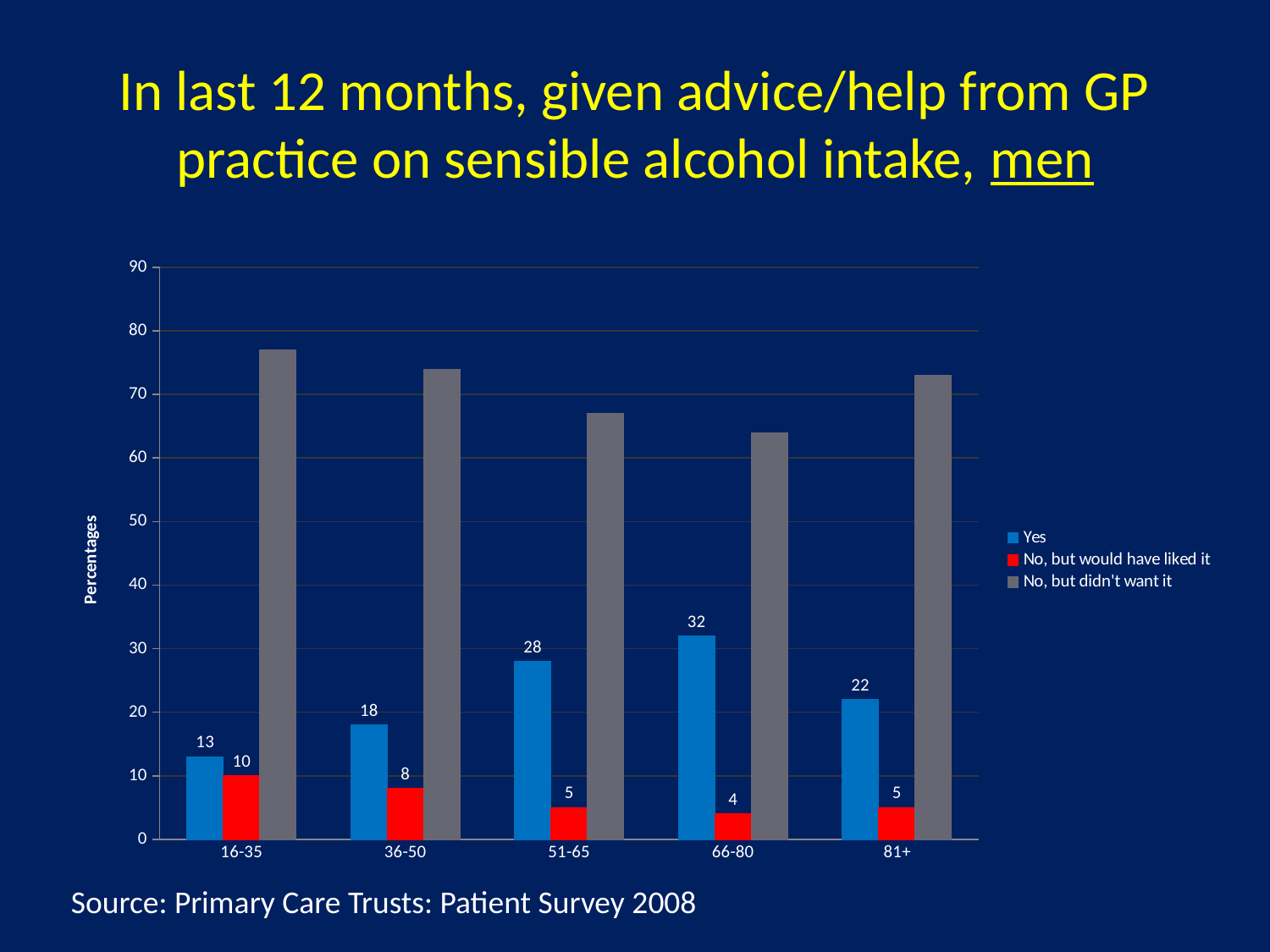
How many age groups are shown on the x axis? 5 What is the difference between the 'Yes' values for the 66-80 and 16-35 age groups? 19 Which is larger: the 'Yes' value for 51-65 or the 'Yes' value for 81+? 51-65 Which age group has the lowest 'No, but would have liked it' value? 66-80 Is the value for 'No, but didn't want it' in the 16-35 age group greater or less than 70? greater Is the value for 'No, but didn't want it' in the 66-80 age group greater or less than 70? less Which age group has the highest 'Yes' value? 66-80 What is the value for 'No, but would have liked it' in the 16-35 age group? 10 What is the label of the y axis? Percentages What kind of chart is shown on the slide? Bar chart How many series does the legend list? 3 What is the value for the 'Yes' series in the 66-80 age group? 32